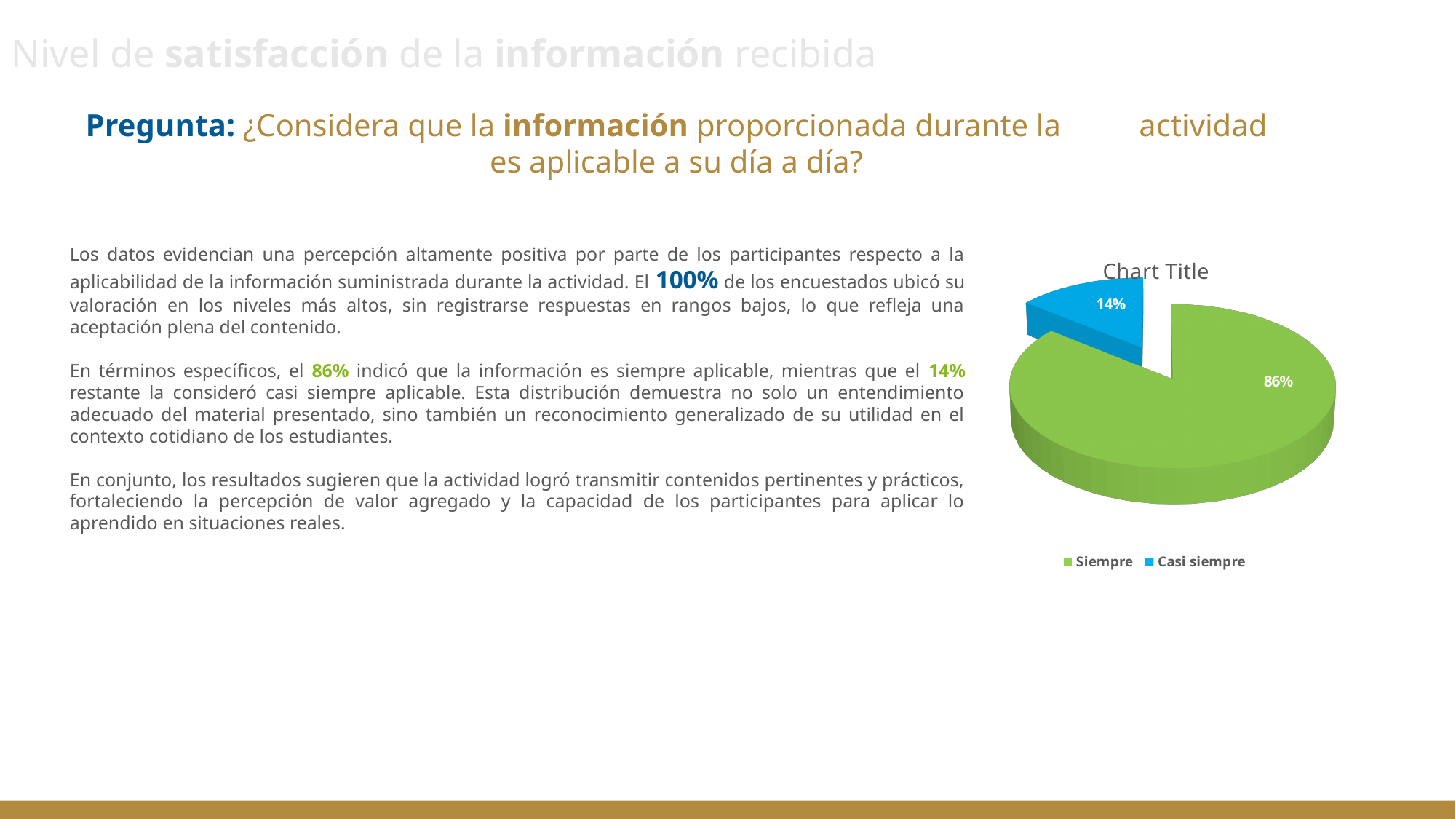
What is the total of the two slice percentages shown on the pie chart? 100% What is the title shown above the pie chart? Chart Title Which category has the largest slice of the pie? Siempre What percentage of the pie is labelled for Siempre? 86% How many entries does the legend list? 2 What kind of chart is shown on the slide? pie chart Which category has the smallest slice of the pie? Casi siempre What percentage of the pie is labelled for Casi siempre? 14% Which slice is larger, Siempre or Casi siempre? Siempre How many slices does the pie chart have? 2 What is the difference in percentage points between the Siempre and Casi siempre slices? 72 What colour is the Casi siempre slice? blue